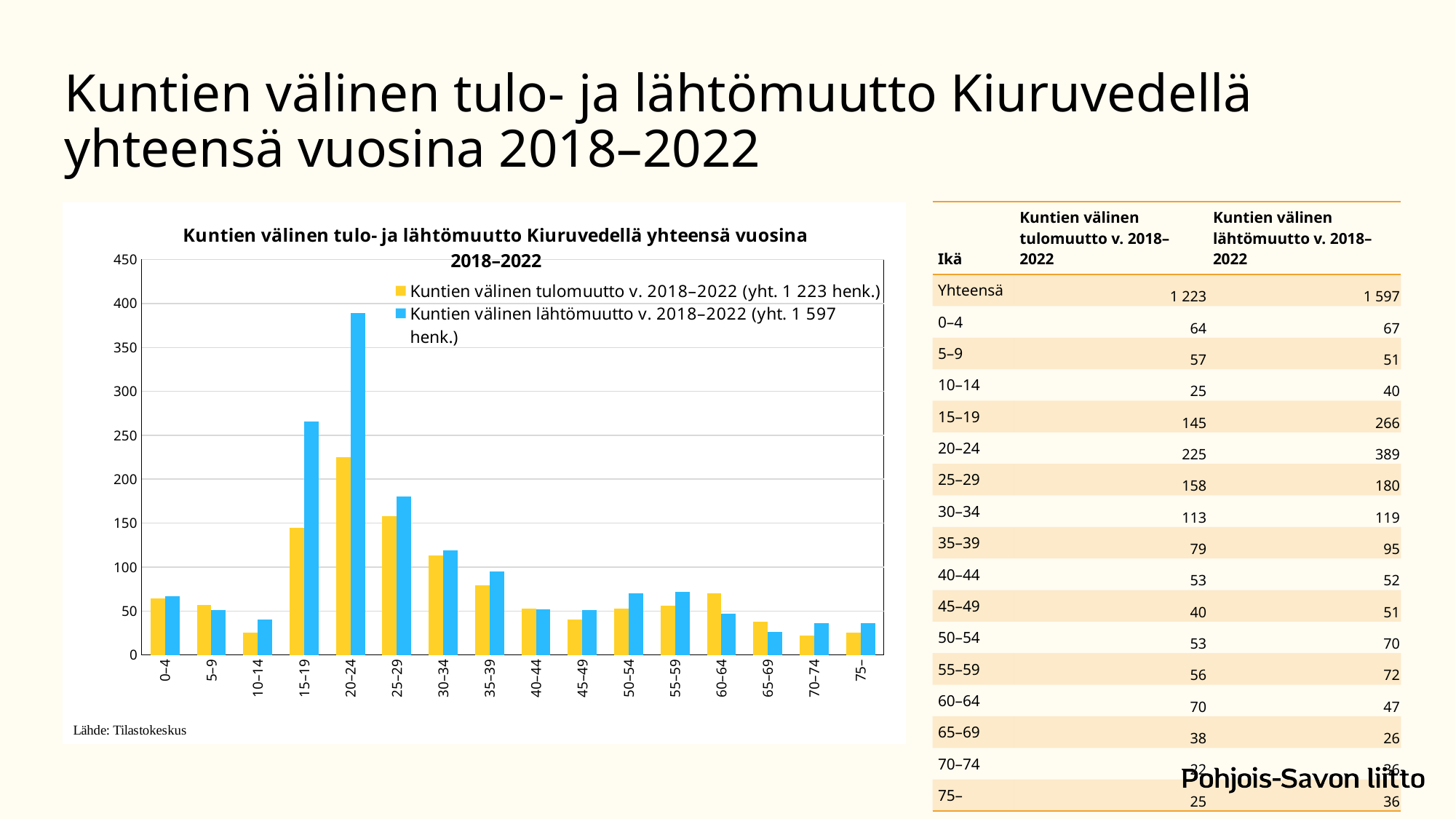
How many series does the chart's legend list? 2 What is the difference between lähtömuutto and tulomuutto for the 20–24 age group? 164 Which age group has the lowest value for Kuntien välinen lähtömuutto v. 2018–2022? 65–69 Which age group has the highest value for Kuntien välinen tulomuutto v. 2018–2022? 20–24 What total number of people does the legend give for Kuntien välinen lähtömuutto v. 2018–2022? 1 597 henk. What kind of chart is shown on the slide? bar chart How many age groups are shown on the x axis of the chart? 16 What is the value of Kuntien välinen lähtömuutto v. 2018–2022 for the 20–24 age group? 389 For the 60–64 age group, which is larger: tulomuutto or lähtömuutto? tulomuutto What is the value of Kuntien välinen tulomuutto v. 2018–2022 for the 15–19 age group? 145 Which age group has the highest value for Kuntien välinen lähtömuutto v. 2018–2022? 20–24 Is the value of Kuntien välinen lähtömuutto v. 2018–2022 for the 20–24 age group greater or less than 350? greater